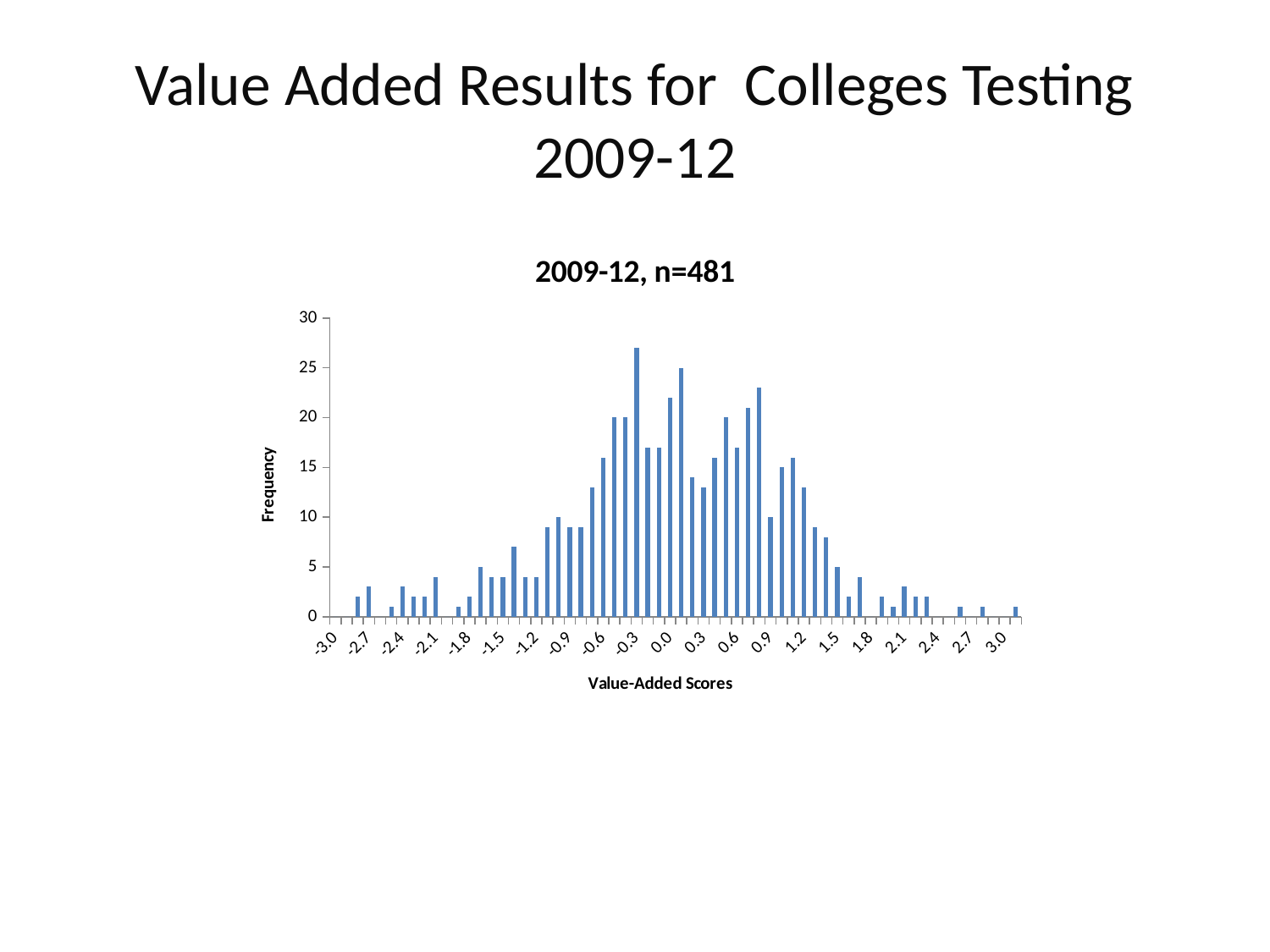
Is the tallest bar in the chart greater or less than 25? greater What is the title of the chart? 2009-12, n=481 What is the label on the vertical axis of the chart? Frequency Is the value for 2.4 greater or less than 5? less What kind of chart is shown on the slide? bar chart Do the frequencies generally rise or fall as the value-added score goes from 0.0 to 3.0? fall Is the value for 0.6 greater or less than 10? greater Do the frequencies generally rise or fall as the value-added score goes from -3.0 to 0.0? rise Which has the larger frequency, the value-added score 0.0 or 2.4? 0.0